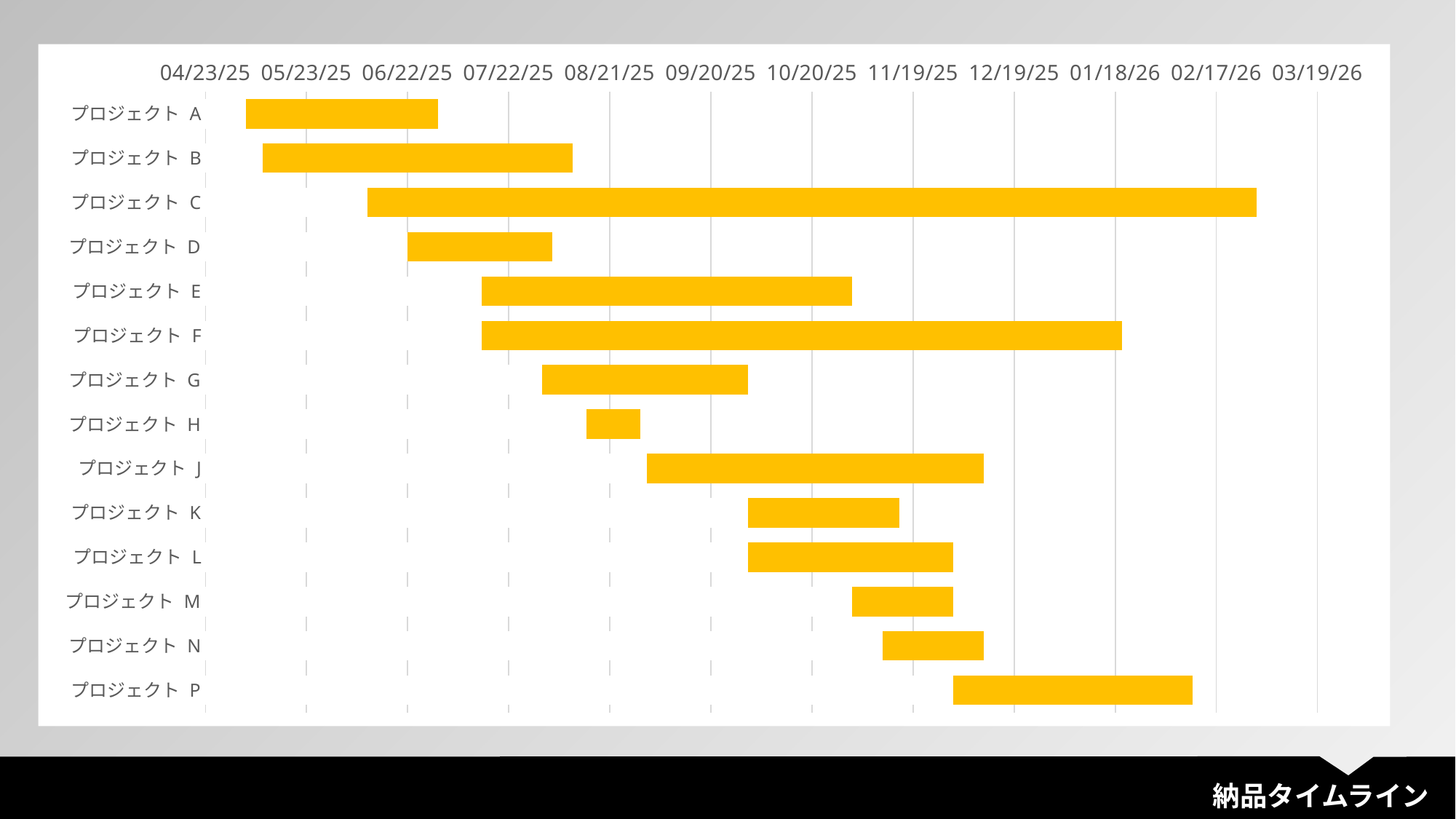
What kind of chart is shown on the slide? Bar chart (Gantt chart) Which project's bar ends latest on the timeline? プロジェクト C How many projects are listed on the vertical axis of the chart? 14 Which project has the shortest bar in the chart? プロジェクト H Which bar is longer, プロジェクト F or プロジェクト G? プロジェクト F Which project's bar starts earliest on the timeline? プロジェクト A Which bar is longer, プロジェクト B or プロジェクト D? プロジェクト B Does the bar for プロジェクト P start before or after 11/19/25? after Does the bar for プロジェクト A end before or after 07/22/25? before Does the bar for プロジェクト C end before or after 02/17/26? after What colour are the bars in the chart? Yellow/orange Which project has the longest bar in the chart? プロジェクト C